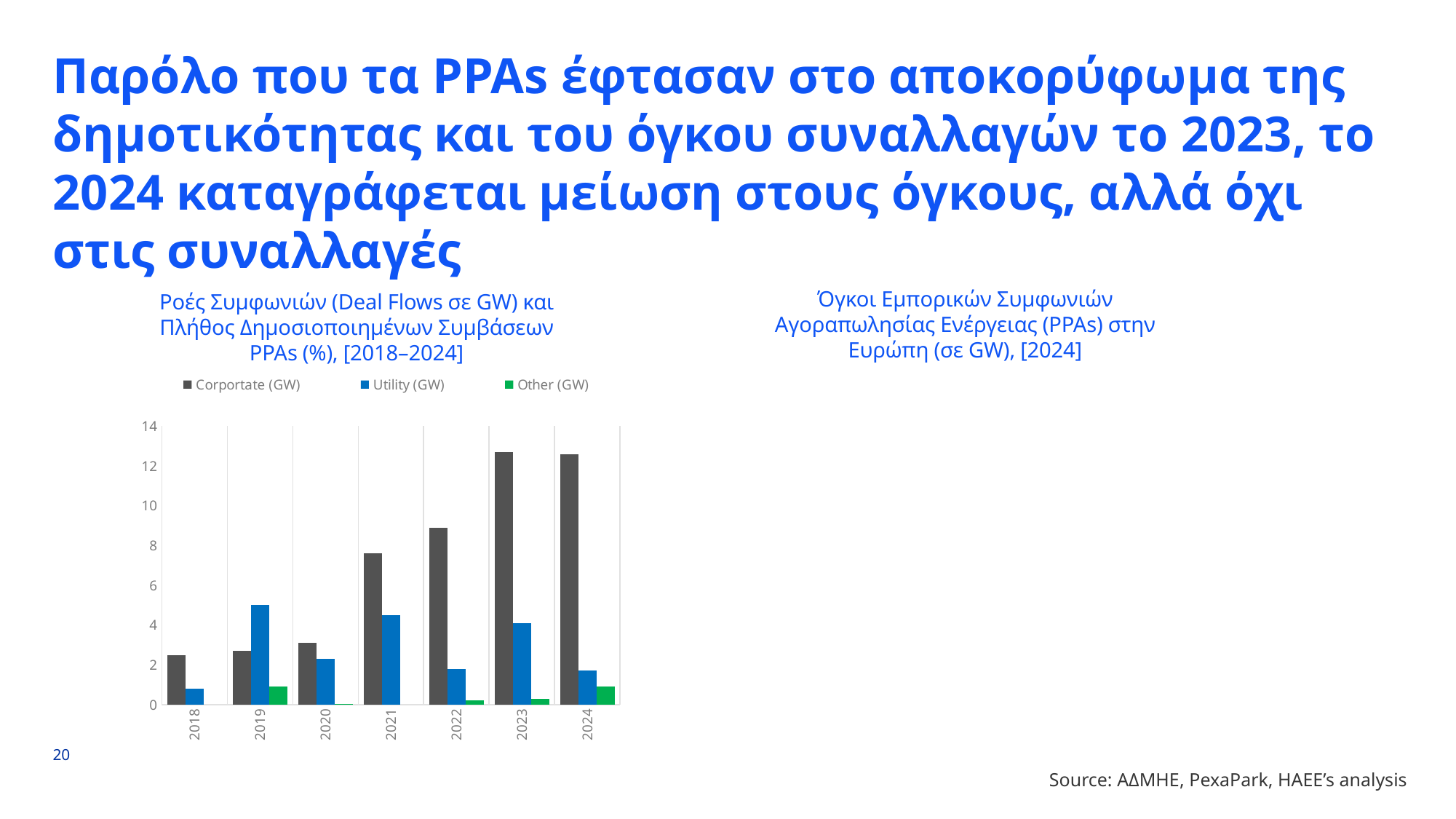
What kind of chart is shown on the slide? Bar chart How many years are shown on the x axis of the chart? 7 Is the Utility (GW) value for 2024 greater or less than 2? less Is the Utility (GW) value for 2019 greater or less than 4? greater How many series does the legend of the chart list? 3 Does the Corportate (GW) series rise or fall from 2018 to 2023? Rise In 2021, which is larger: the Corportate (GW) value or the Utility (GW) value? Corportate (GW) In which year is the Utility (GW) value the lowest? 2018 Is the Corportate (GW) value for 2021 greater or less than 8? less In which year is the Utility (GW) value the highest? 2019 What colour represents the Other (GW) series in the chart? Green